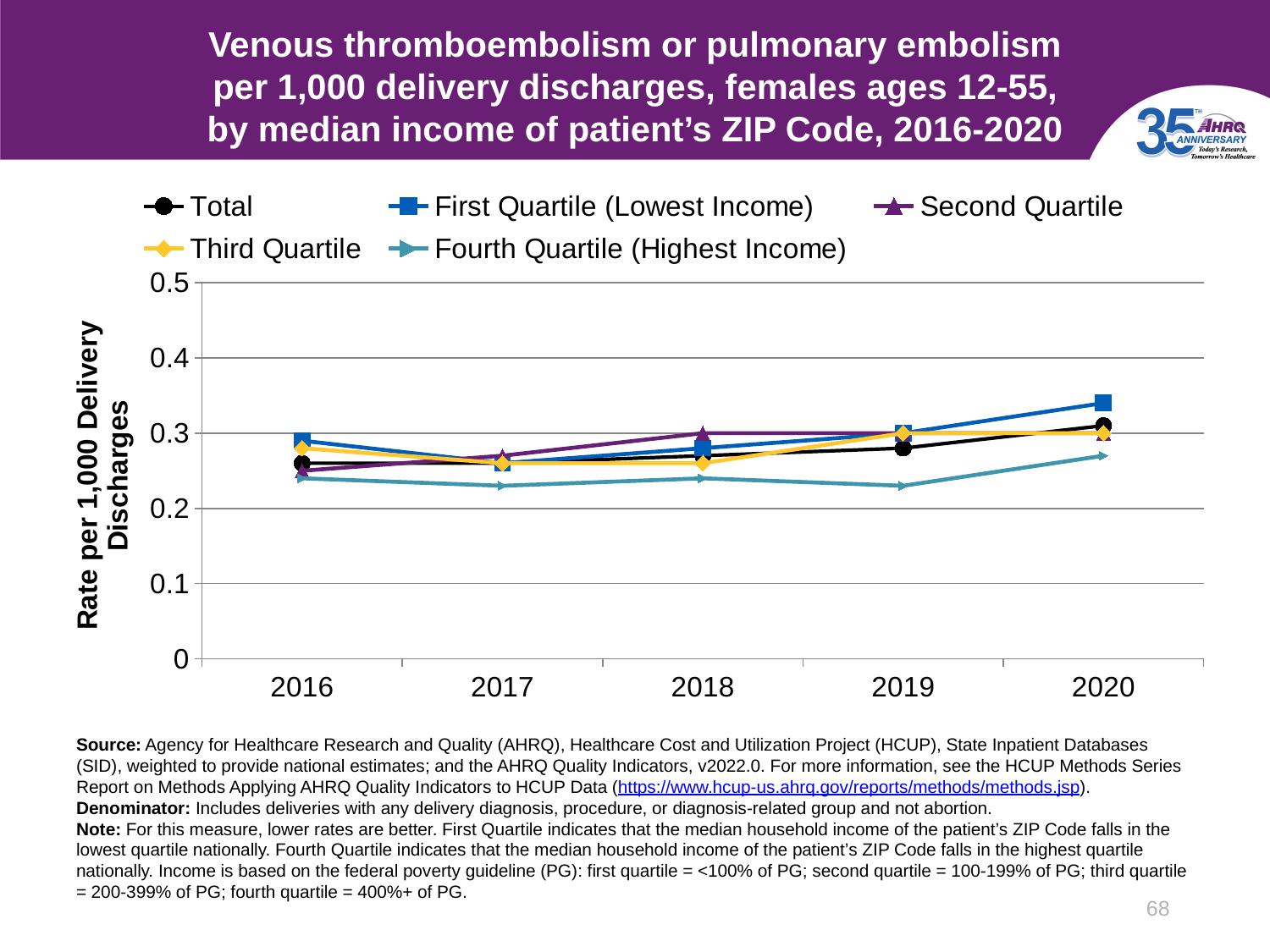
What kind of chart is shown on the slide? line chart In 2020, which is larger: the value for First Quartile (Lowest Income) or the value for Fourth Quartile (Highest Income)? First Quartile (Lowest Income) How many years are plotted along the x axis? 5 Is the value for Fourth Quartile (Highest Income) in 2017 greater or less than 0.2? greater Which series has the lowest value in 2019? Fourth Quartile (Highest Income) Is the value for Fourth Quartile (Highest Income) in 2020 greater or less than 0.3? less Does the Total series rise or fall from 2019 to 2020? rise Which series has the lowest value in 2020? Fourth Quartile (Highest Income) Which series has the highest value in 2020? First Quartile (Lowest Income) How many series does the legend list? 5 What is the label of the y axis? Rate per 1,000 Delivery Discharges Is the value for First Quartile (Lowest Income) in 2020 greater or less than 0.3? greater